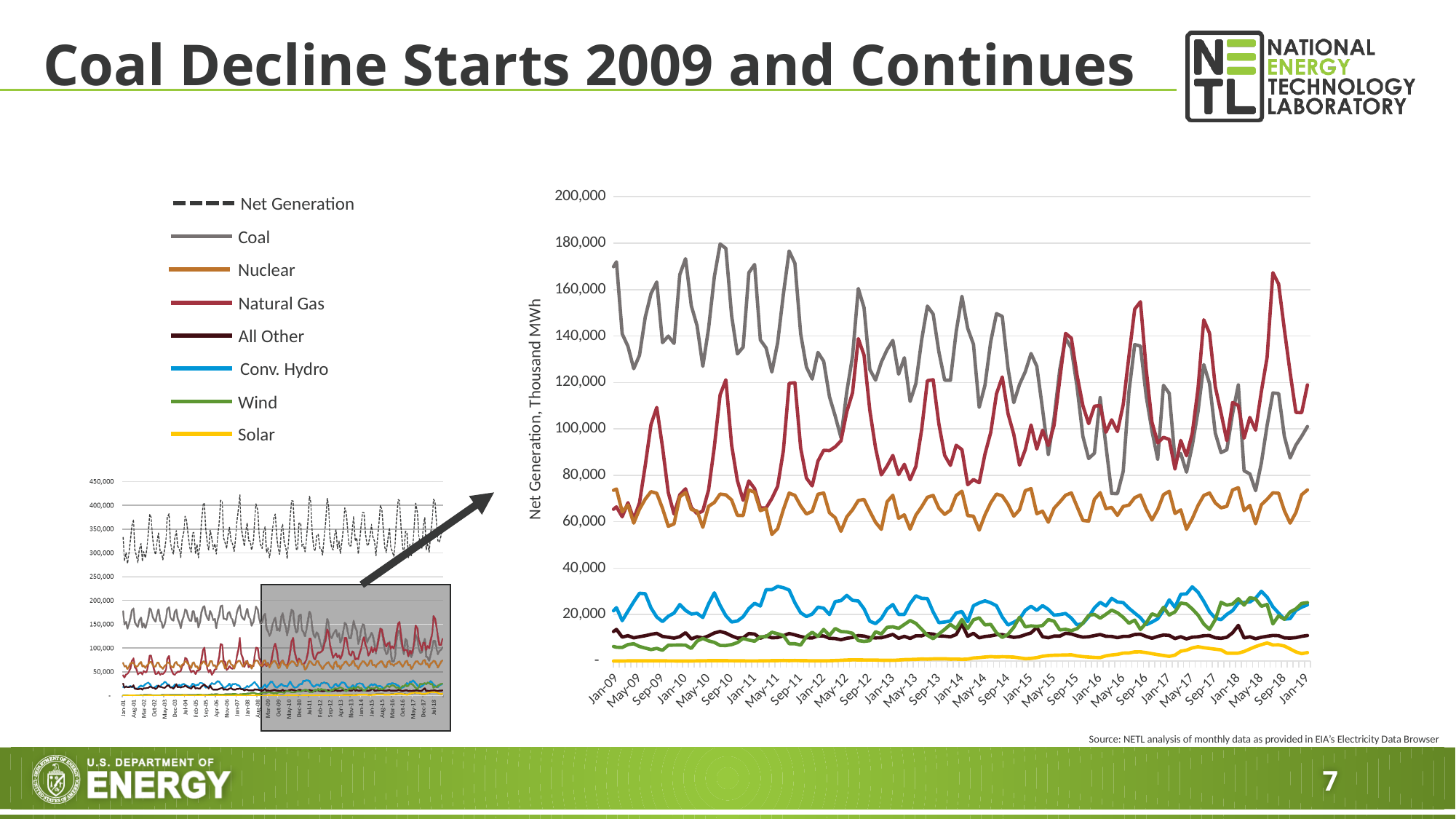
How many series does the legend on the slide list? 8 What is the title of the slide? Coal Decline Starts 2009 and Continues In the large chart on the right, is the value for Solar in Jan-19 greater or less than 20,000? less In the large chart on the right, does the Coal series generally rise or fall from Jan-09 to Jan-19? Fall In the large chart on the right, does the Natural Gas series generally rise or fall from Jan-09 to Jan-19? Rise What is the y-axis label of the large chart on the right? Net Generation, Thousand MWh In the large chart on the right, which series stays lowest across the whole period? Solar What kind of chart is the large chart on the right of the slide? Line chart In the large chart on the right, is the value for Coal in Jan-09 greater or less than 160,000? greater In the large chart on the right, which is larger in Jan-19, Natural Gas or Coal? Natural Gas In the large chart on the right, is the value for Nuclear in Jan-09 greater or less than 80,000? less In the large chart on the right, which is larger in Jan-09, Coal or Natural Gas? Coal